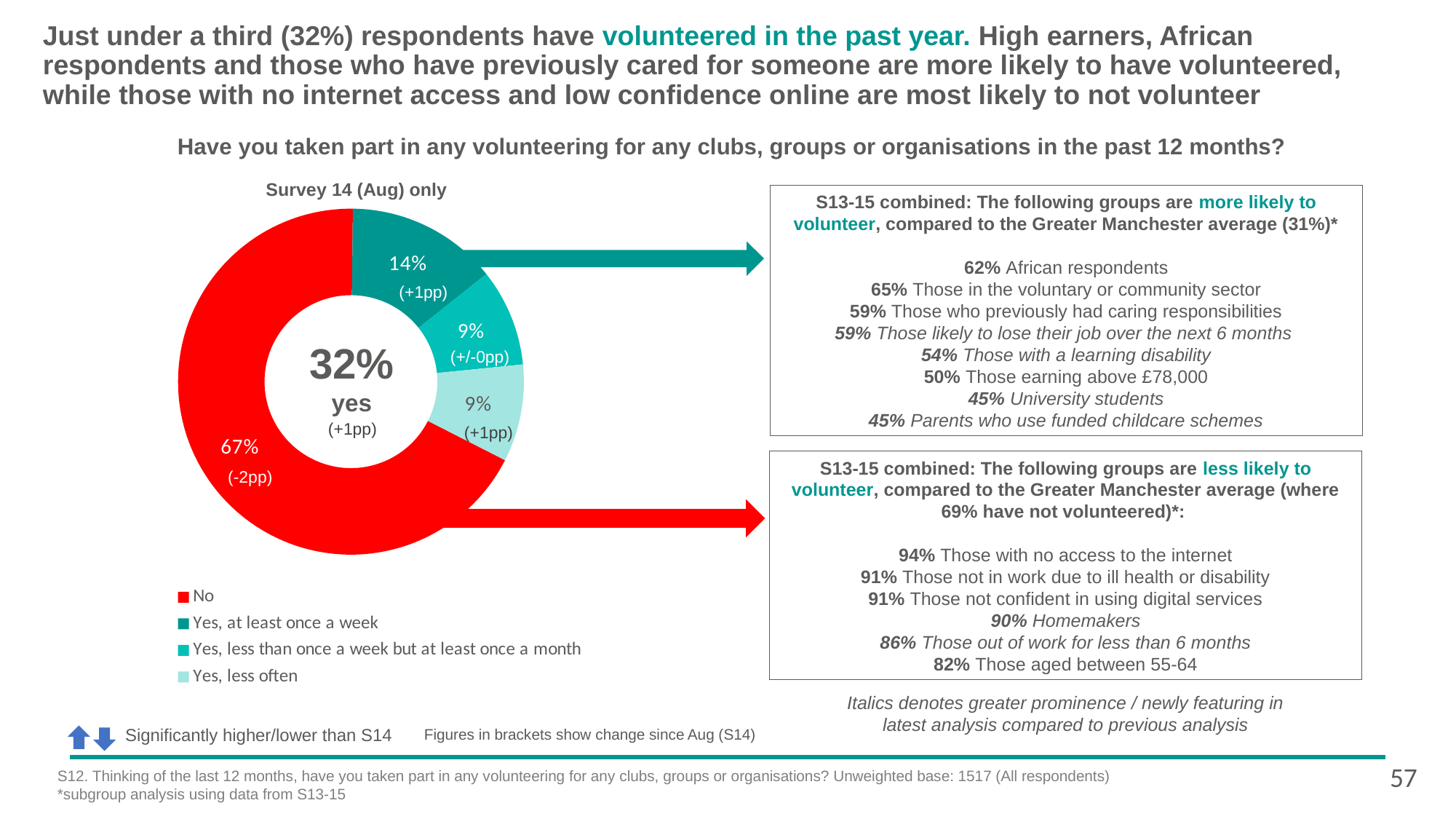
What percentage of respondents answered "No" in the donut chart? 67% What colour is the "No" slice in the donut chart? Red Which category has the largest share of the donut chart? No How many categories does the legend of the donut chart list? 4 Which is larger: the share for "No" or the share for "Yes, at least once a week"? No What percentage of respondents answered "Yes, less than once a week but at least once a month"? 9% What percentage of respondents answered "Yes, at least once a week"? 14% What type of chart is shown on the slide? Pie chart (donut) What percentage of respondents answered "Yes, less often"? 9% What overall percentage of respondents said yes, as shown in the centre of the donut chart? 32% What change since the previous survey is shown in brackets for the "No" slice? -2pp What is the difference in percentage points between the "No" slice and the "Yes, at least once a week" slice? 53 percentage points